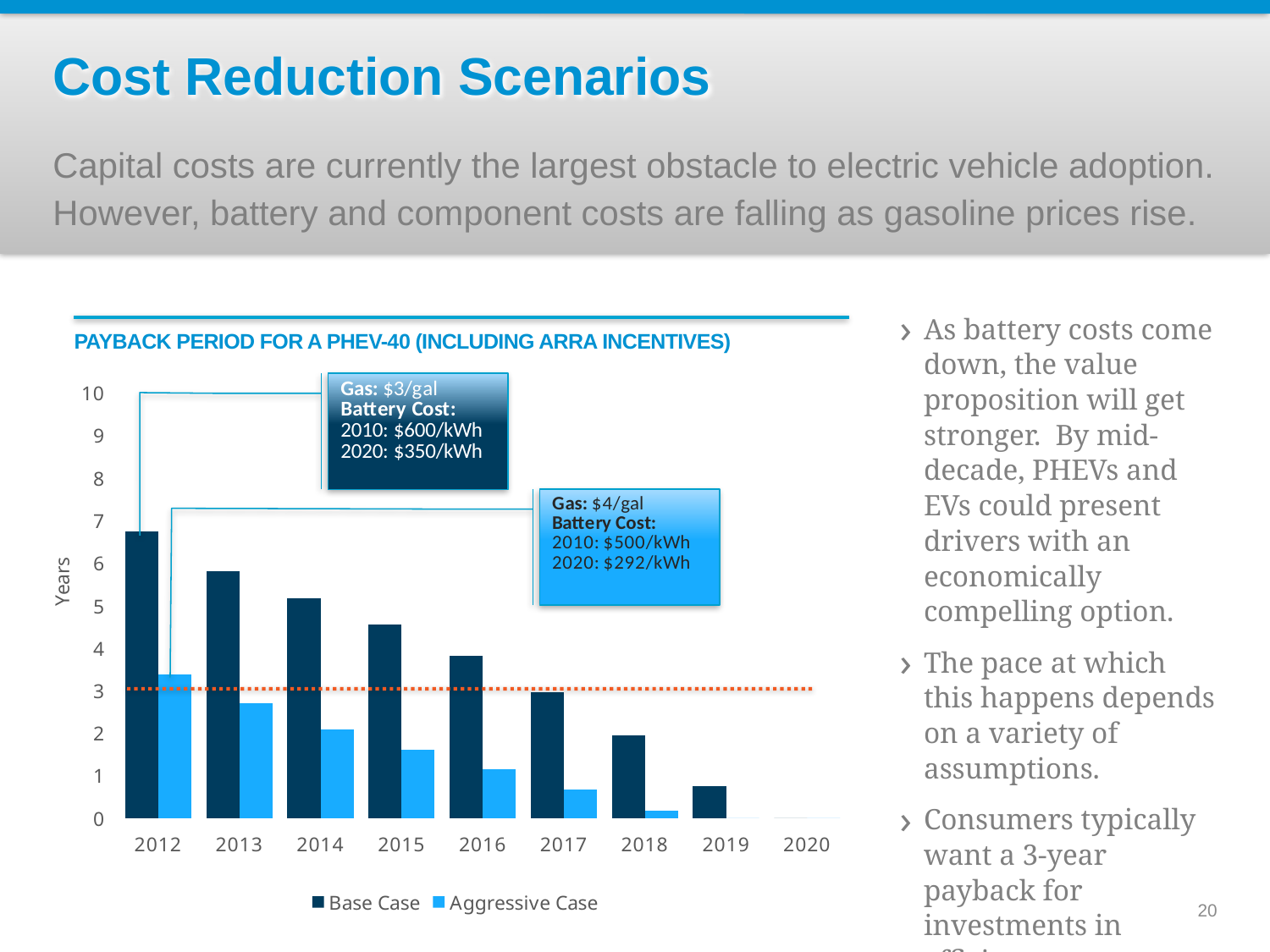
Is the Base Case value for 2012 greater or less than 6? greater Is the Aggressive Case value for 2013 greater or less than 3? less What kind of chart is shown on the slide? Bar chart Do the Base Case values rise or fall from 2012 to 2020? Fall How many years are shown on the x axis? 9 In 2014, which is larger, the Base Case or the Aggressive Case value? Base Case How many series does the legend list? 2 What is the title of the chart? PAYBACK PERIOD FOR A PHEV-40 (INCLUDING ARRA INCENTIVES) Which year has the highest Base Case payback period? 2012 What is the label on the y axis of the chart? Years Is the Base Case value for 2015 greater or less than 4? greater